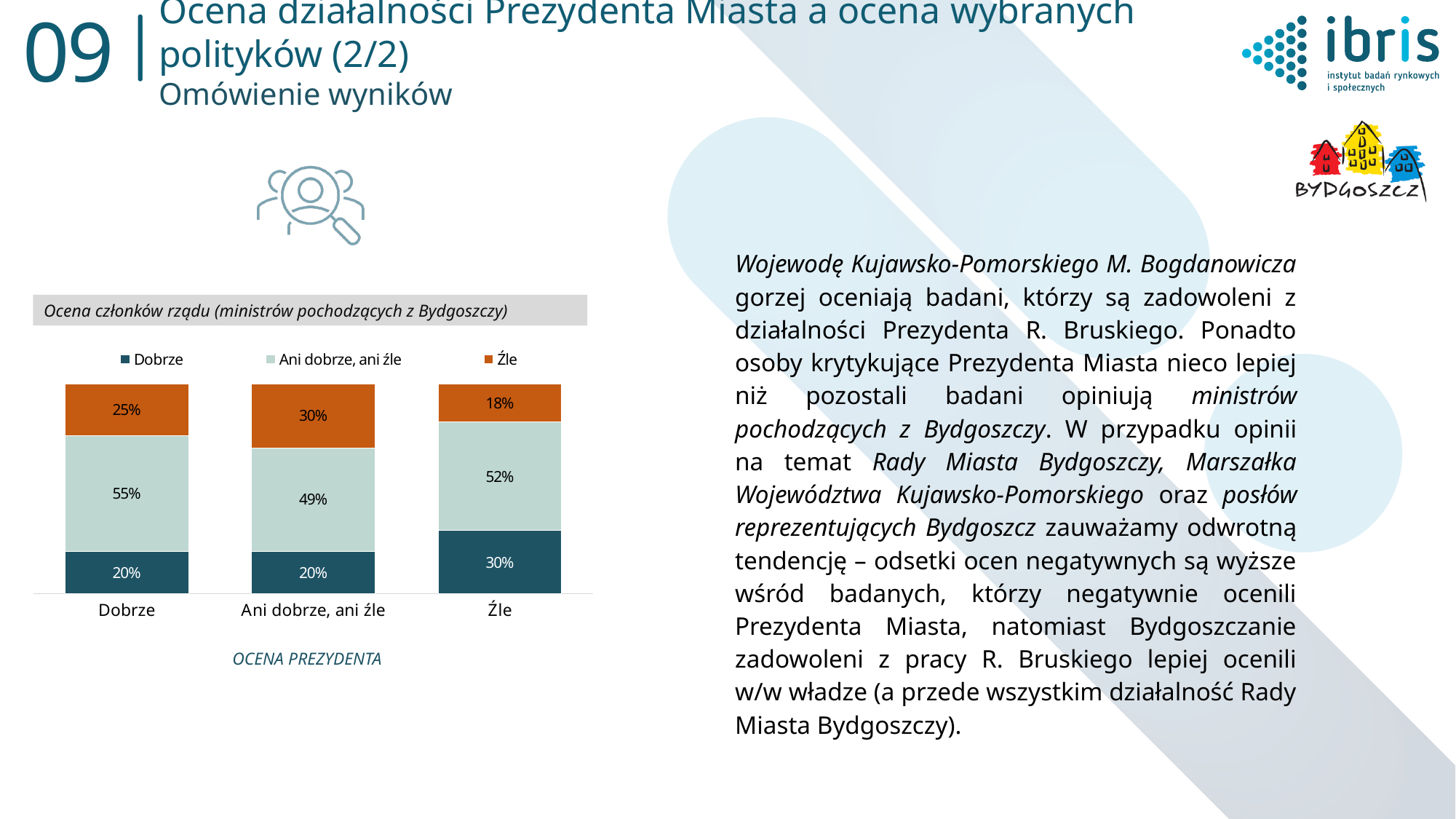
What is the title of the chart? Ocena członków rządu (ministrów pochodzących z Bydgoszczy) What is the difference between the 'Źle' series values for the 'Ani dobrze, ani źle' and 'Źle' categories? 12% How many series does the chart legend list? 3 What kind of chart is shown on the slide? stacked bar chart What is the value of the 'Ani dobrze, ani źle' series for the 'Dobrze' category? 55% How many categories are shown on the x axis of the chart? 3 What is the value of the 'Źle' series for the 'Ani dobrze, ani źle' category? 30% Which category has the lowest value for the 'Ani dobrze, ani źle' series? Ani dobrze, ani źle What is the value of the 'Dobrze' series for the 'Źle' category? 30% What is the value of the 'Źle' series for the 'Źle' category? 18% Which category has the highest value for the 'Źle' series? Ani dobrze, ani źle Which is larger: the 'Dobrze' series value for the 'Źle' category or for the 'Dobrze' category? Źle